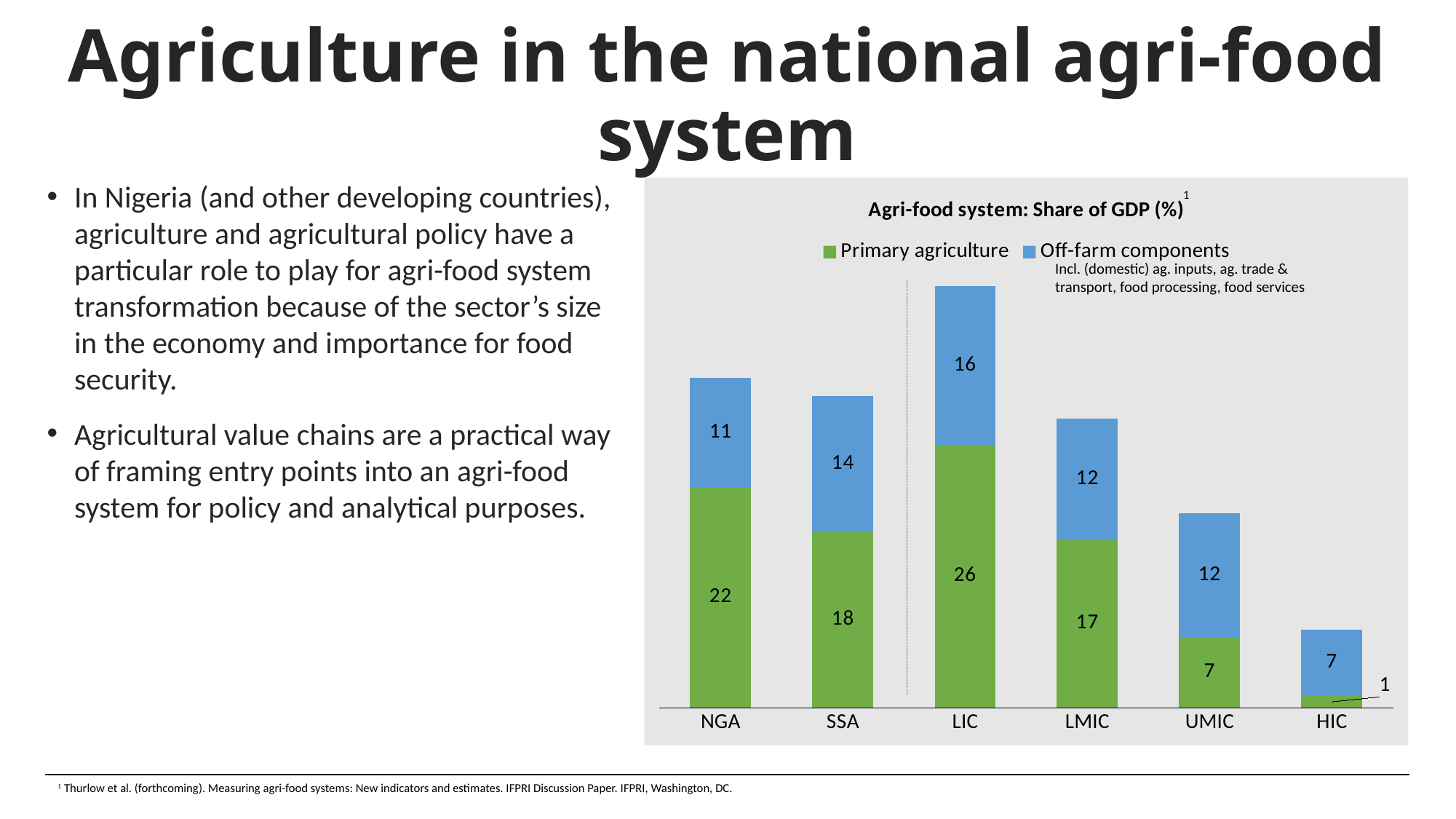
What kind of chart is shown on the slide? Stacked bar chart What is the Primary agriculture value for HIC? 1 How many categories are shown on the x axis? 6 What is the title of the chart? Agri-food system: Share of GDP (%) What is the Off-farm components value for SSA? 14 Which category has the highest Primary agriculture value? LIC What is the Primary agriculture value for NGA? 22 How many series does the legend list? 2 Which is larger: the Off-farm components value for LIC or for LMIC? LIC Which category has the lowest Off-farm components value? HIC What is the difference between the Primary agriculture values for NGA and SSA? 4 What is the total of the stacked bar for LIC? 42